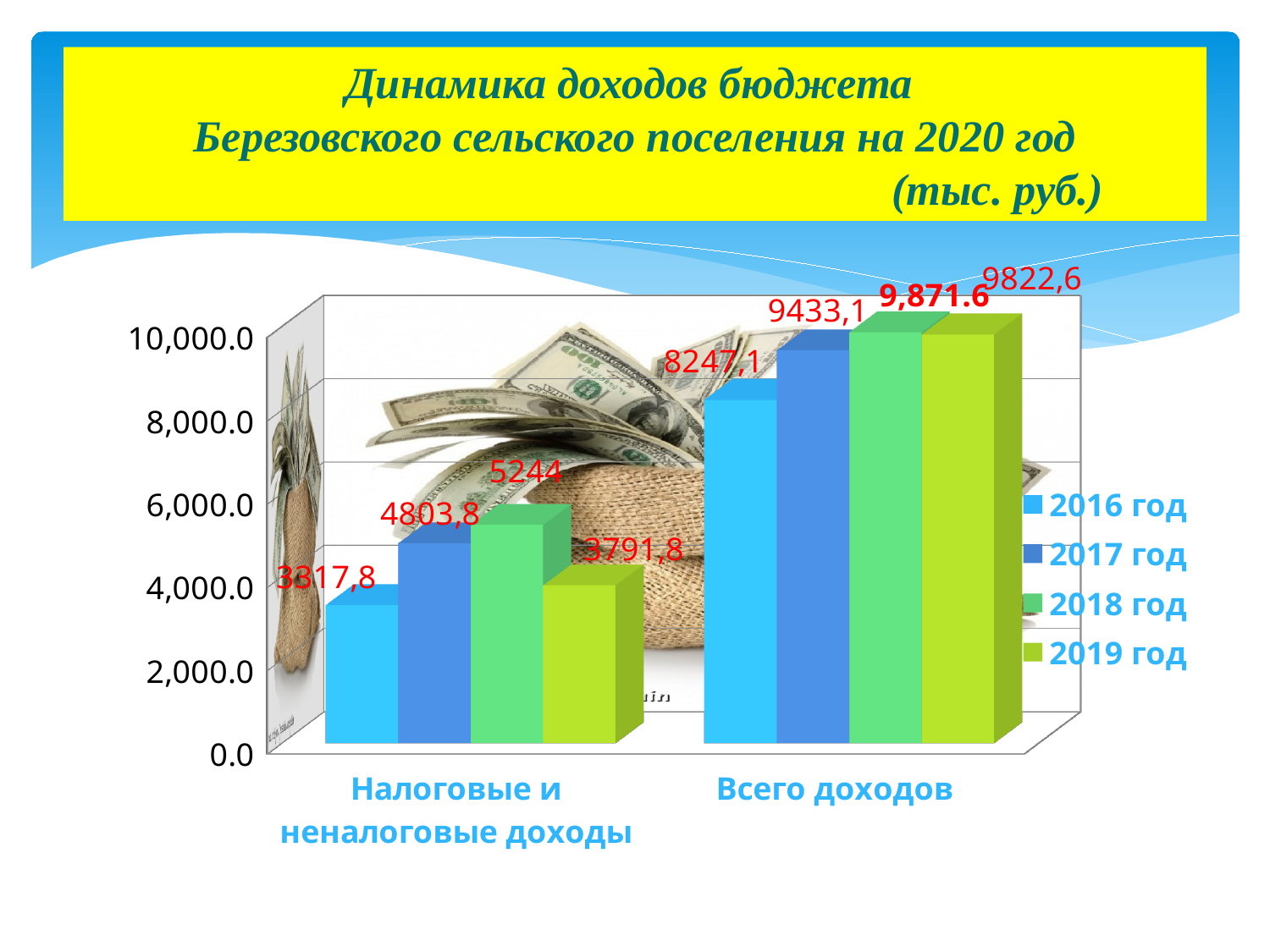
How many categories are shown on the x axis? 2 How many series does the legend list? 4 What is the value for 2018 год in the category Налоговые и неналоговые доходы? 5244 What is the value for 2016 год in the category Всего доходов? 8247,1 What is the value for 2018 год in the category Всего доходов? 9,871.6 Is the value for 2016 год in the category Налоговые и неналоговые доходы greater or less than 4,000.0? less What is the value for 2019 год in the category Налоговые и неналоговые доходы? 3791,8 What kind of chart is shown on the slide? bar chart What is the value for 2017 год in the category Налоговые и неналоговые доходы? 4803,8 In the category Всего доходов, which is larger: the value for 2017 год or for 2019 год? 2019 год Which year has the highest value in the category Налоговые и неналоговые доходы? 2018 год What is the value for 2019 год in the category Всего доходов? 9822,6